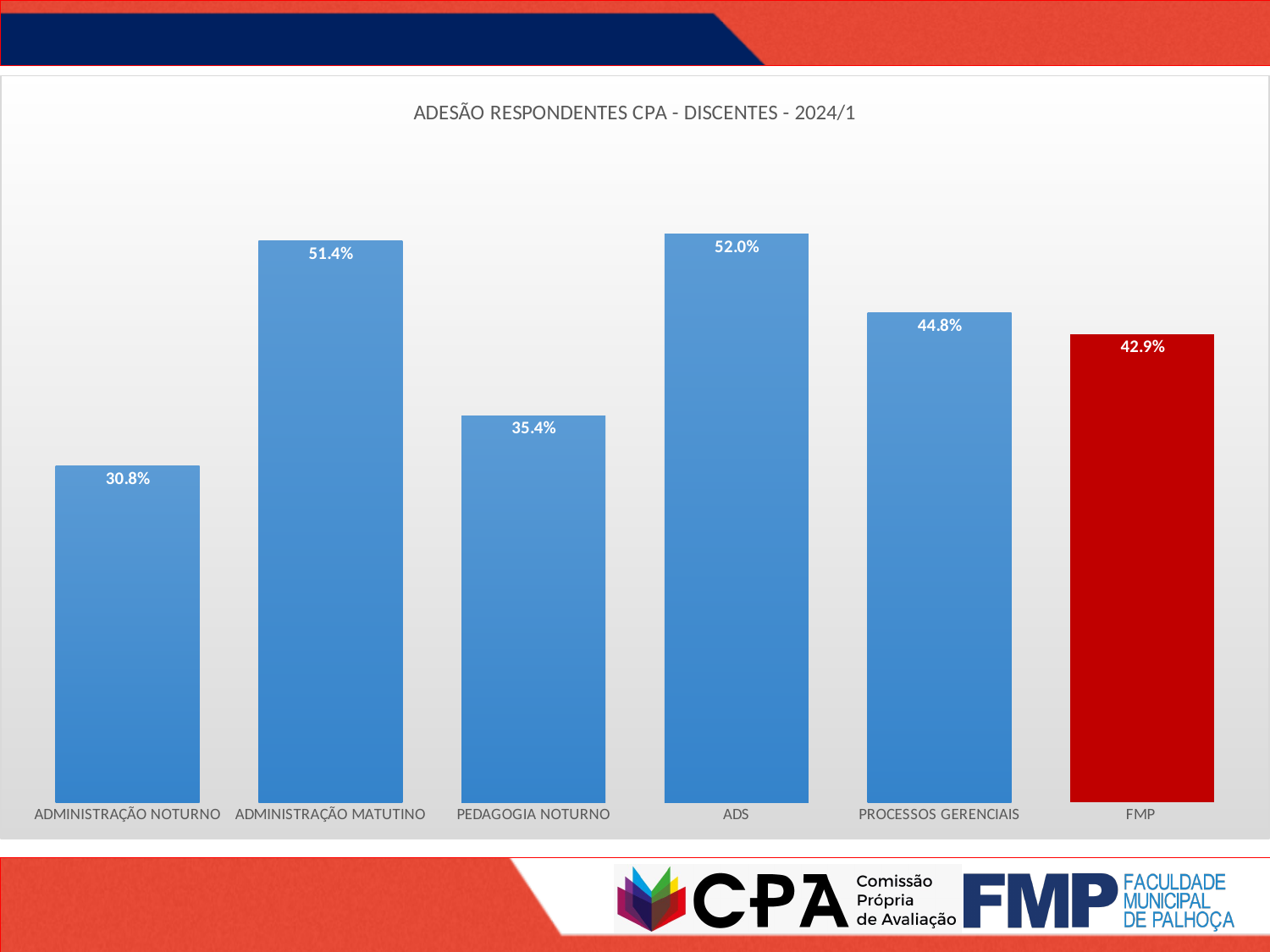
Which category has the lowest value? ADMINISTRAÇÃO NOTURNO What is the difference between the values for PROCESSOS GERENCIAIS and FMP? 1.9% What kind of chart is shown on the slide? Bar chart Which category has the highest value? ADS What is the value for ADMINISTRAÇÃO NOTURNO? 30.8% Which bar is coloured red rather than blue? FMP What is the value for FMP? 42.9% Which is larger, the value for PEDAGOGIA NOTURNO or the value for FMP? FMP What is the difference between the values for ADMINISTRAÇÃO MATUTINO and ADMINISTRAÇÃO NOTURNO? 20.6% What is the title of the chart? ADESÃO RESPONDENTES CPA - DISCENTES - 2024/1 How many categories are shown in the chart? 6 What is the value for PROCESSOS GERENCIAIS? 44.8%